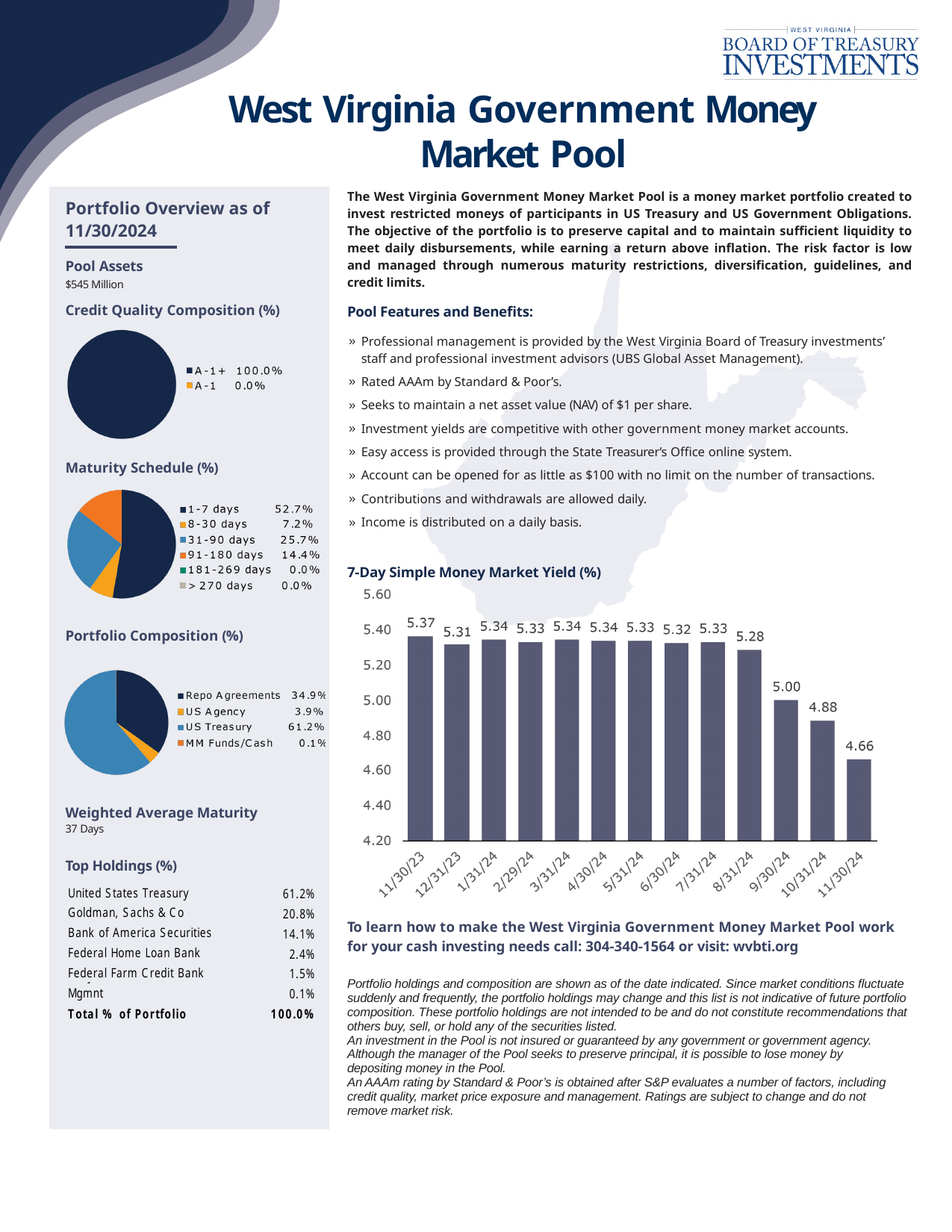
In the 7-Day Simple Money Market Yield (%) chart, what is the difference between the values for 11/30/23 and 11/30/24? 0.71 In the 7-Day Simple Money Market Yield (%) chart, how many months are plotted? 13 In the 7-Day Simple Money Market Yield (%) chart, which month has the highest yield? 11/30/23 In the 7-Day Simple Money Market Yield (%) chart, what is the value for 9/30/24? 5.00 In the 7-Day Simple Money Market Yield (%) chart, what is the value for 11/30/24? 4.66 In the Portfolio Composition (%) pie chart, what share is Repo Agreements? 34.9% What kind of chart is the 7-Day Simple Money Market Yield (%) chart? Bar chart In the Credit Quality Composition (%) pie chart, how many entries does the legend list? 2 In the 7-Day Simple Money Market Yield (%) chart, which month has the lowest yield? 11/30/24 In the 7-Day Simple Money Market Yield (%) chart, do the values generally rise or fall from 8/31/24 to 11/30/24? Fall In the Maturity Schedule (%) pie chart, what share is 31-90 days? 25.7% In the Maturity Schedule (%) pie chart, which category has the largest share? 1-7 days